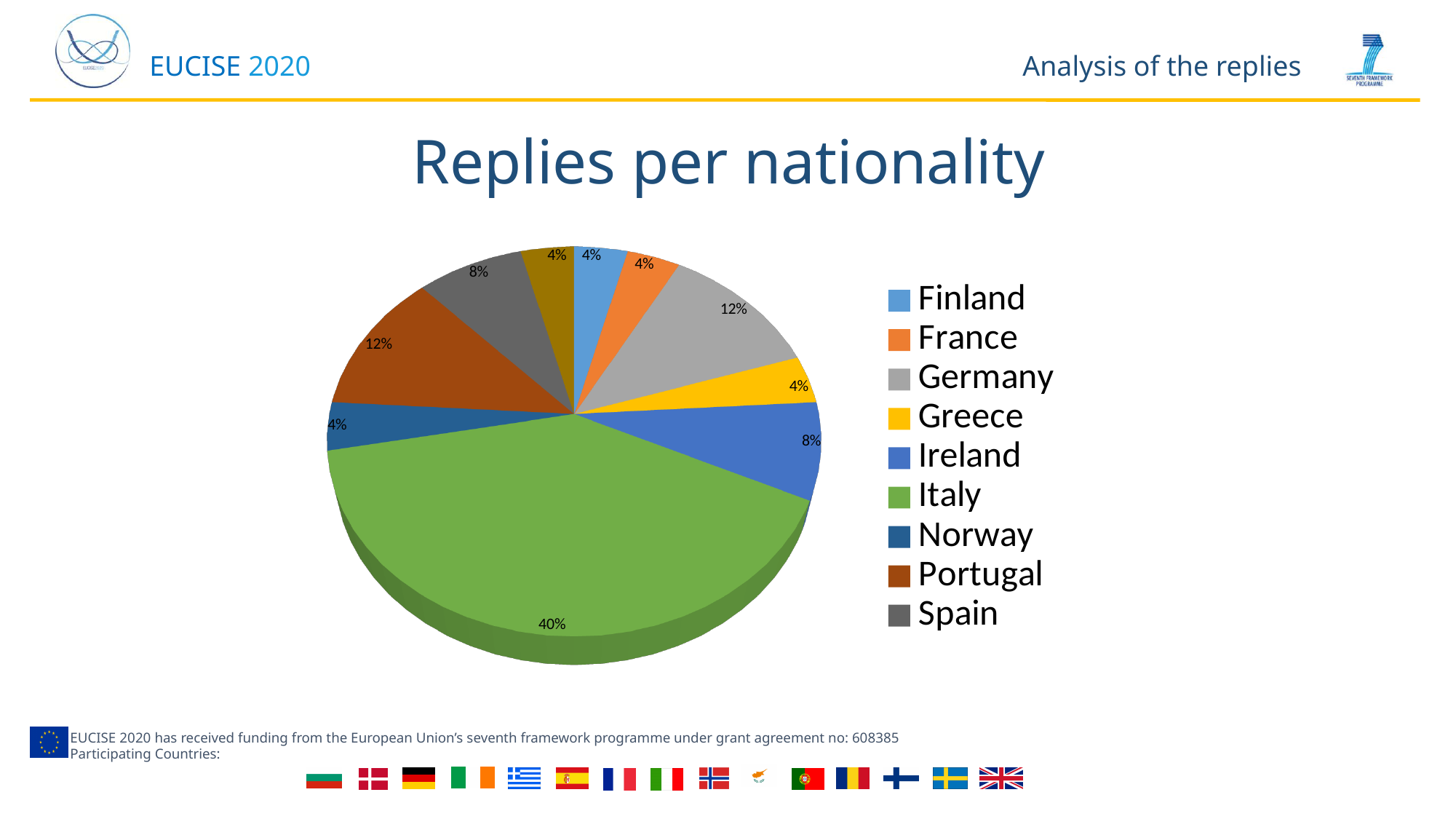
Which nationality has the largest share of replies? Italy What is the title of the chart? Replies per nationality What is the value shown for Spain? 8% What is the value shown for Ireland? 8% What is the value shown for Greece? 4% What kind of chart is shown on the slide? Pie chart What is the value shown for Germany? 12% How many entries does the legend list? 9 What is the value shown for Portugal? 12% Which is larger, the share for Germany or the share for Ireland? Germany What share of replies does Italy account for in the pie chart? 40% What is the difference between the shares for Italy and Germany? 28%